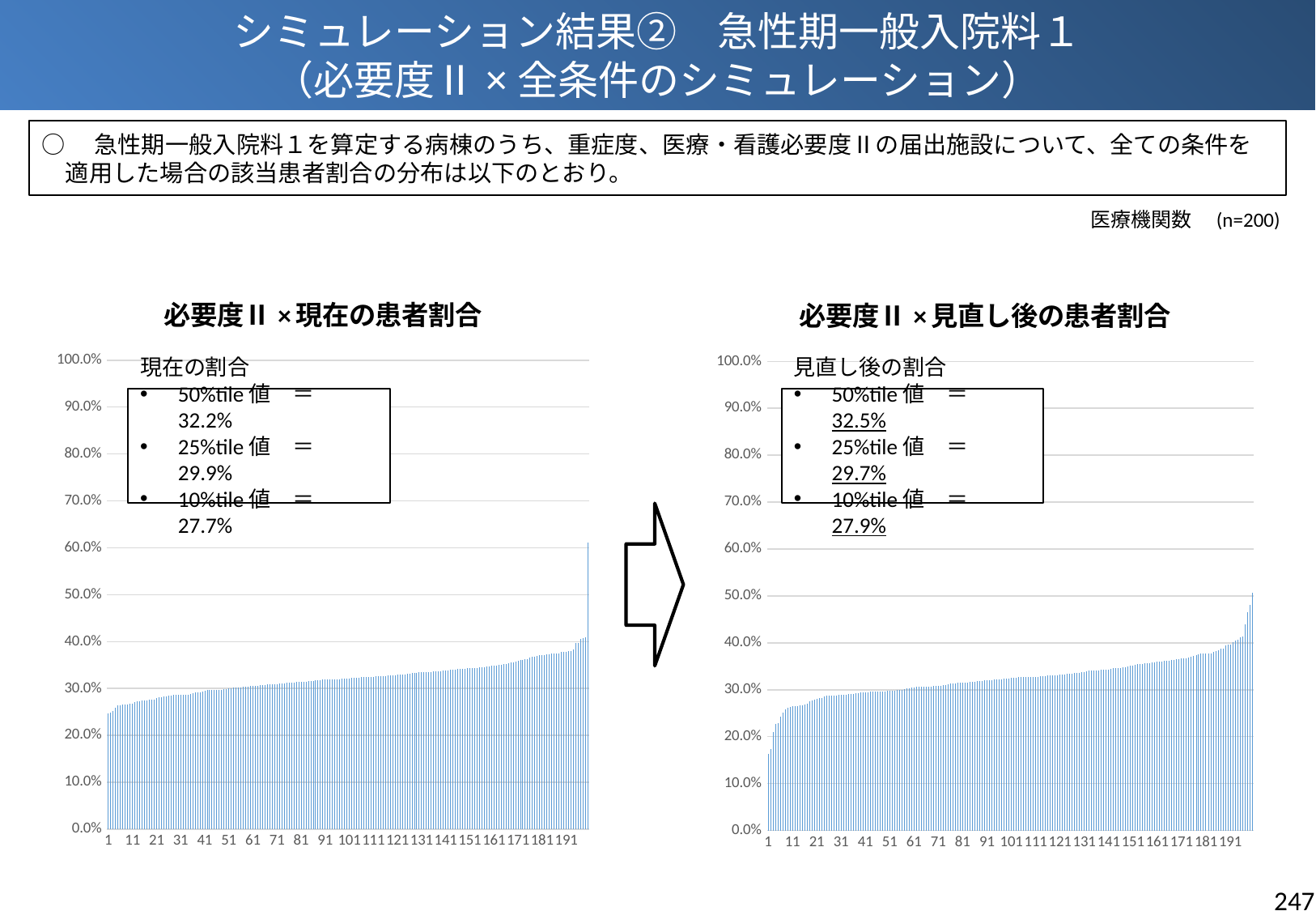
In the right chart (必要度Ⅱ×見直し後の患者割合), what is the 50%tile value shown in the text box? 32.5% In the left chart (必要度Ⅱ×現在の患者割合), what is the 50%tile value shown in the text box? 32.2% What kind of chart is the left chart titled 必要度Ⅱ×現在の患者割合? bar chart In the left chart (必要度Ⅱ×現在の患者割合), is the value of the tallest bar greater or less than 50.0%? greater In the left chart (必要度Ⅱ×現在の患者割合), what is the 25%tile value shown in the text box? 29.9% In the right chart (必要度Ⅱ×見直し後の患者割合), do the bar values rise or fall from left to right along the x axis? rise What is the difference between the 50%tile value in the right chart (32.5%) and the 50%tile value in the left chart (32.2%)? 0.3% Which chart shows the higher 50%tile value, the left chart (現在の患者割合) or the right chart (見直し後の患者割合)? the right chart (見直し後の患者割合) In the left chart (必要度Ⅱ×現在の患者割合), what is the 10%tile value shown in the text box? 27.7% In the right chart (必要度Ⅱ×見直し後の患者割合), what is the 10%tile value shown in the text box? 27.9% In the right chart (必要度Ⅱ×見直し後の患者割合), is the value of the first (leftmost) bar greater or less than 20.0%? less In the left chart (必要度Ⅱ×現在の患者割合), do the bar values rise or fall from left to right along the x axis? rise